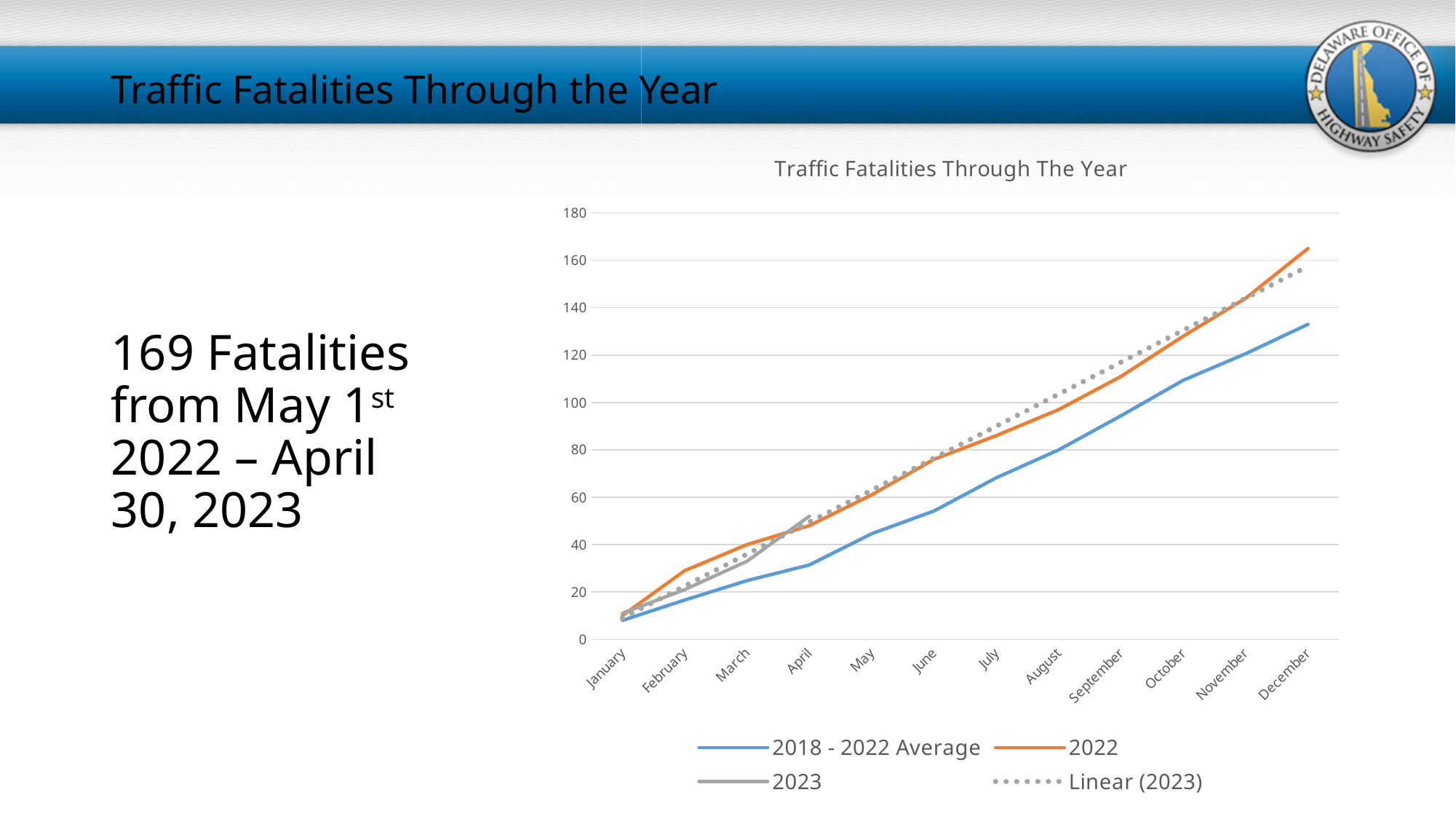
Is the value for the 2018 - 2022 Average in September greater or less than 100? less Is the value for the 2018 - 2022 Average in December greater or less than 140? less Is the value for the 2018 - 2022 Average in December greater or less than 120? greater Do the values for the 2022 series rise or fall from January to December? rise How many series does the legend list? 4 In December, which is larger: the 2022 value or the 2018 - 2022 Average value? 2022 What kind of chart is shown on the slide? line chart What is the title of the chart? Traffic Fatalities Through The Year Which series reaches the highest value in December? 2022 Which series is drawn as a dotted line? Linear (2023) How many months are shown along the x axis? 12